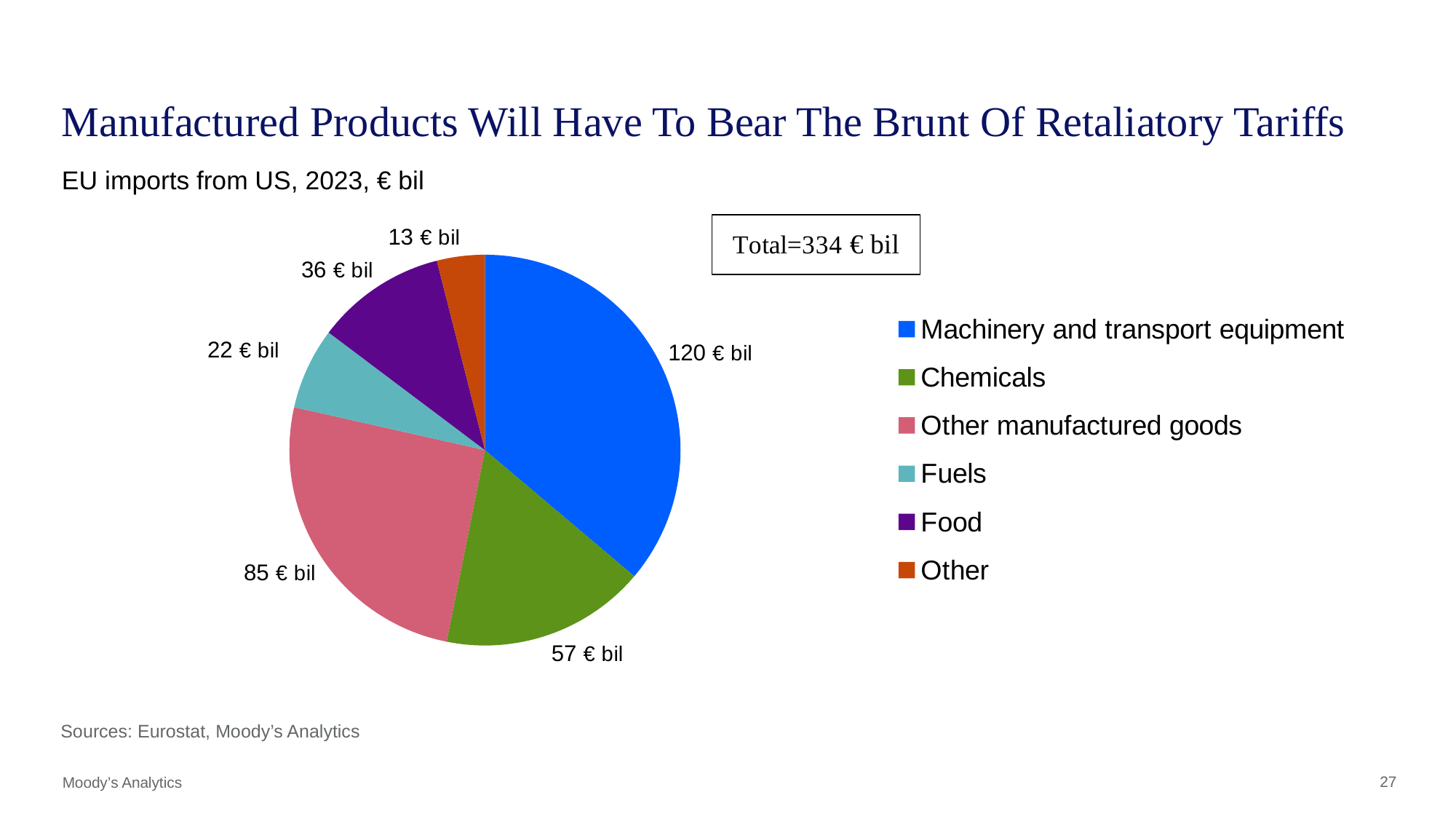
Which category has the largest slice of the pie? Machinery and transport equipment What is the value for Food? 36 € bil How many categories does the legend list? 6 What total is shown in the box on the slide? Total=334 € bil Which is larger, Food or Fuels? Food What is the value for Fuels? 22 € bil What kind of chart is shown on the slide? Pie chart What is the value for Chemicals? 57 € bil Which category has the smallest slice of the pie? Other What is the value for Machinery and transport equipment? 120 € bil What is the difference between Other manufactured goods and Chemicals? 28 € bil